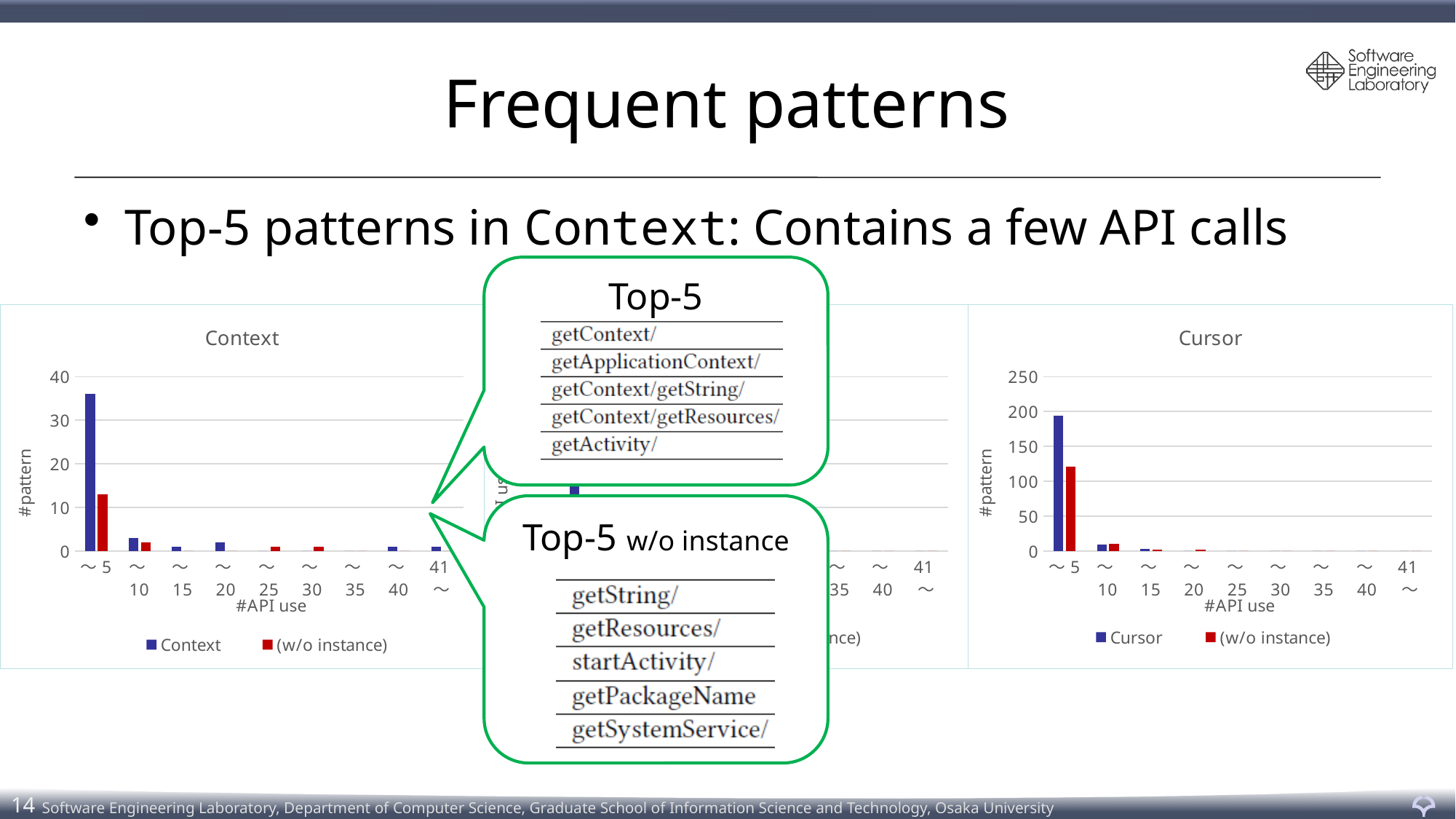
In the Cursor chart, is the value of the Cursor series for the ~5 category greater or less than 150? greater What is the label of the y axis on the Cursor chart? #pattern What kind of chart is the Context chart on the left of the slide? bar chart In the Cursor chart, is the value of the (w/o instance) series for the ~5 category greater or less than 150? less In the Context chart, for the ~5 category, which series has the larger value: Context or (w/o instance)? Context In the Context chart, is the value of the (w/o instance) series for the ~5 category greater or less than 10? greater How many series does the legend of the Context chart list? 2 In the Cursor chart, which #API use category has the highest value for the Cursor series? ~5 What are the two legend entries of the Cursor chart on the right? Cursor and (w/o instance) How many #API use categories are shown on the x axis of the Cursor chart? 9 In the Context chart, which #API use category has the highest value for the Context series? ~5